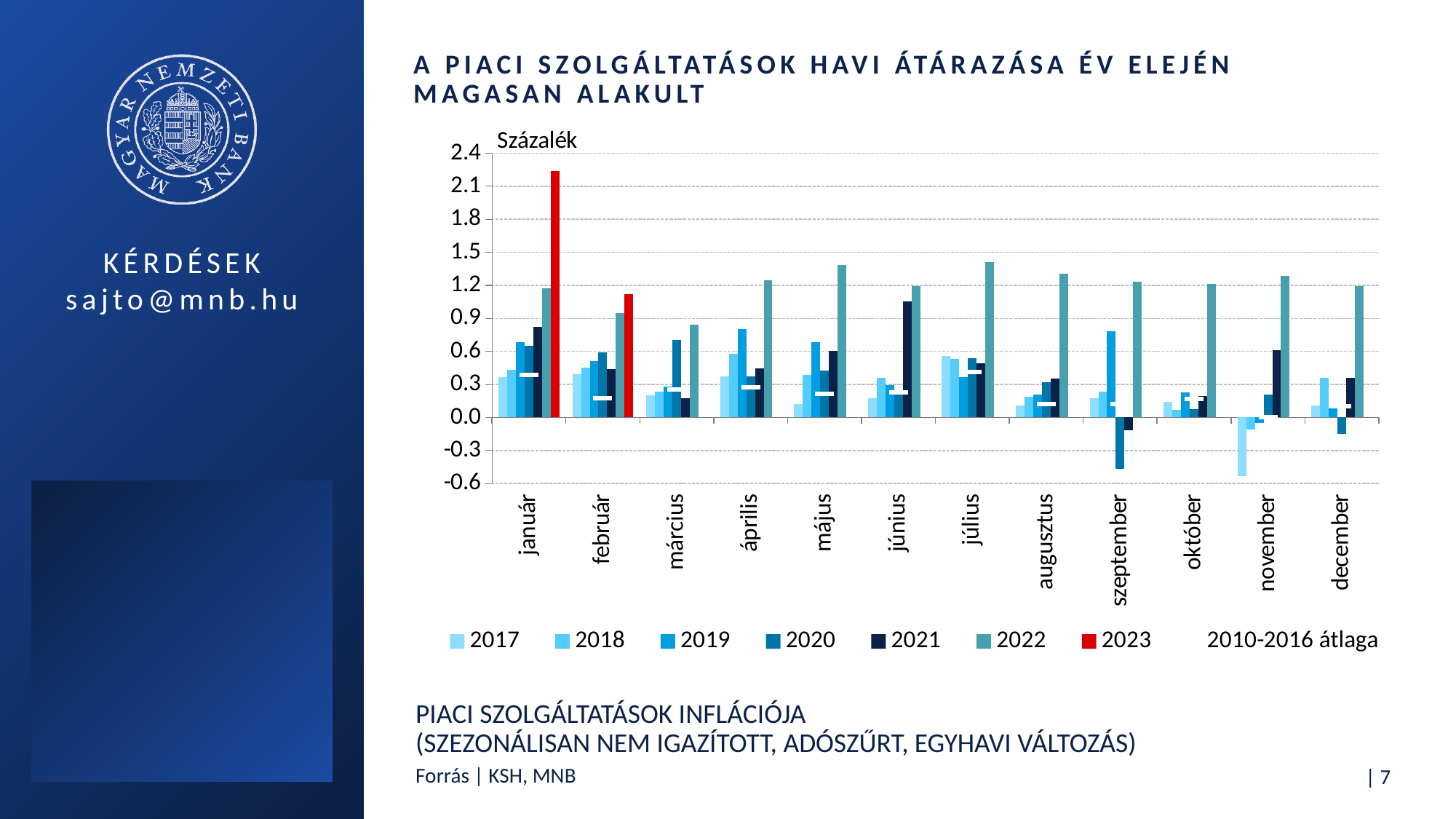
What kind of chart is shown on the slide? bar chart Is the value for 2021 in június greater or less than 0.9? greater In which month is the 2023 bar highest? január Is the value for 2017 in november greater or less than -0.3? less Is the value for 2023 in január greater or less than 1.8? greater What unit label is shown at the top of the y axis? Százalék Which is larger for 2021: the május value or the június value? június How many months (categories) are shown on the x axis? 12 Which is larger in január: the 2023 value or the 2022 value? 2023 How many series does the legend list? 8 Which series has the highest bar in január? 2023